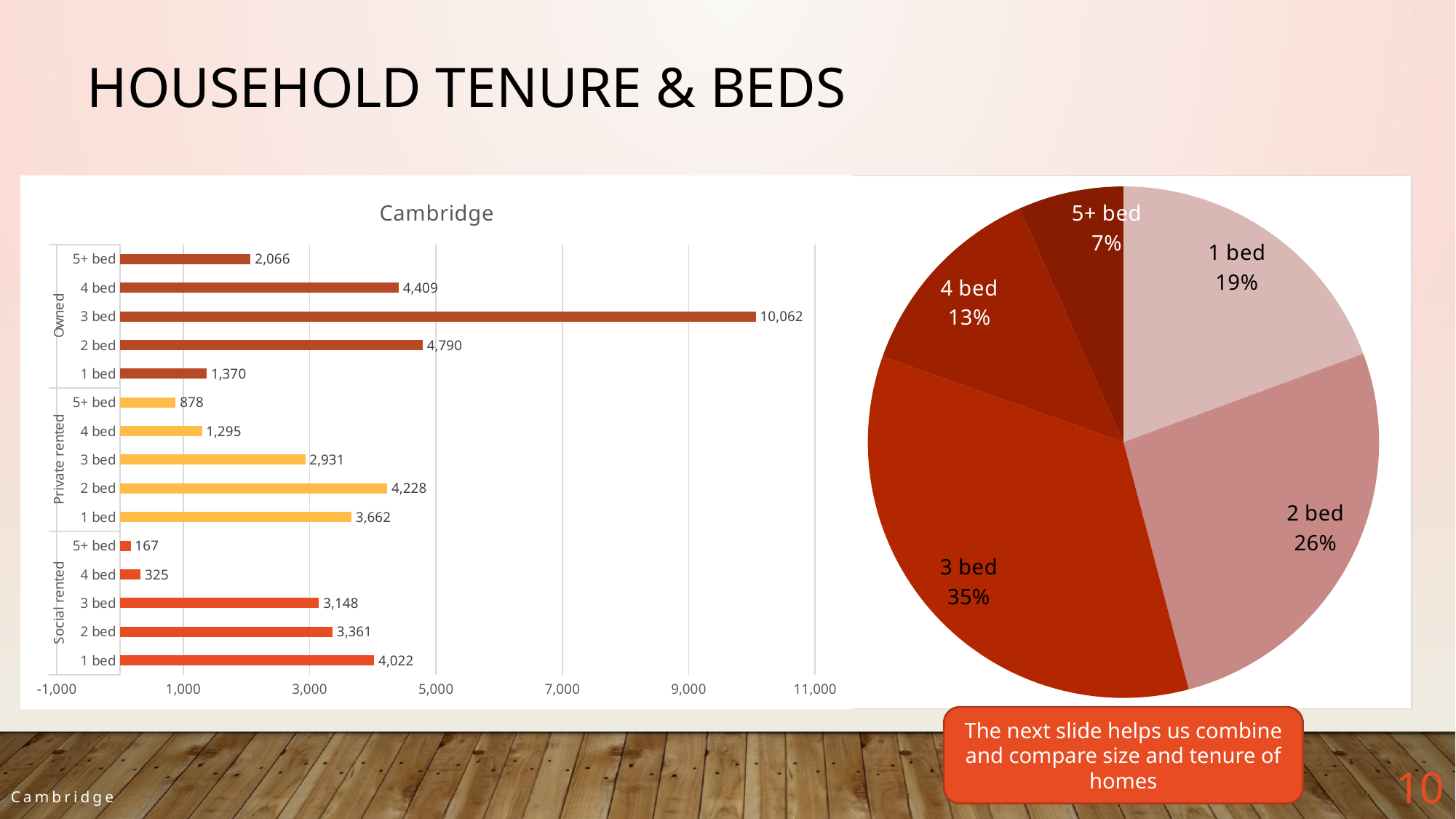
In the bar chart titled Cambridge, which category has the highest value? Owned 3 bed In the bar chart titled Cambridge, how many bars are plotted? 15 In the pie chart on the right, how many slices are there? 5 In the bar chart titled Cambridge, which is larger: Social rented 1 bed or Private rented 1 bed? Social rented 1 bed What kind of chart is the chart on the left of the slide? Bar chart In the bar chart titled Cambridge, what is the difference between Owned 2 bed and Owned 1 bed? 3,420 In the pie chart on the right, what share does 3 bed have? 35% In the bar chart titled Cambridge, what is the value for Private rented 2 bed? 4,228 In the bar chart titled Cambridge, what is the value for Owned 3 bed? 10,062 In the bar chart titled Cambridge, what is the value for Social rented 5+ bed? 167 In the pie chart on the right, which slice is the smallest? 5+ bed In the bar chart titled Cambridge, which category has the lowest value? Social rented 5+ bed